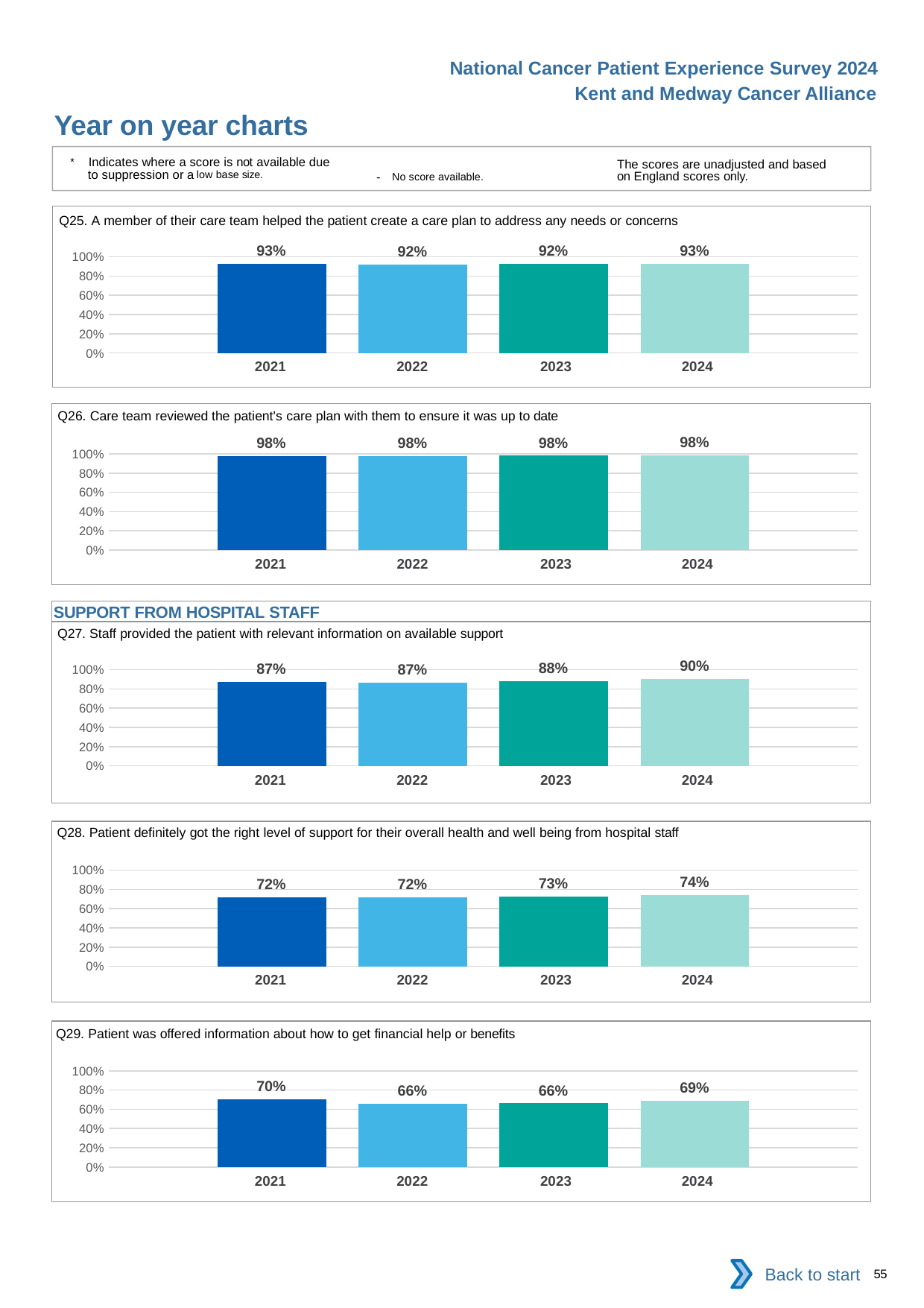
In the Q29 chart, what is the difference between the 2021 and 2022 values? 4% In the Q28 chart, is the value for 2024 greater or less than 80%? less In the Q28 chart, do the values rise or fall from 2021 to 2024? rise How many years are shown in the Q25 chart? 4 In the Q28 chart, what is the value for 2023? 73% In the Q27 chart, which year has the highest value? 2024 In the Q27 chart, what is the difference between the 2024 and 2021 values? 3% In the Q29 chart, which is larger, the value for 2024 or the value for 2023? 2024 What kind of chart is the Q26 chart? bar chart In the Q26 chart, what is the value for 2022? 98% In the Q25 chart, what is the value for 2024? 93% In the Q29 chart, which year has the highest value? 2021